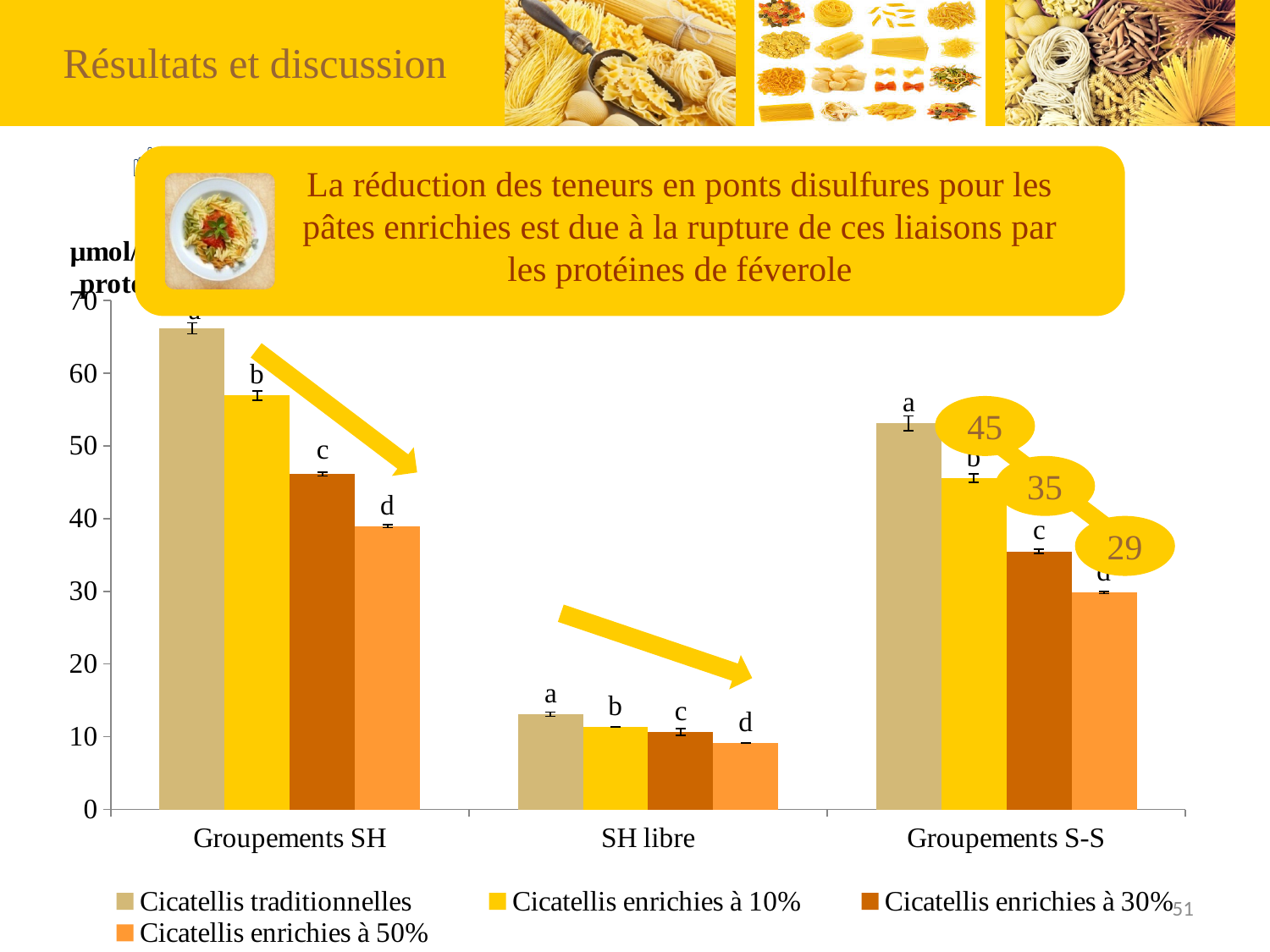
Is the value for Cicatellis traditionnelles in Groupements SH greater or less than 60? greater Within each category, do the bars rise or fall as the enrichment level increases from traditionnelles to 50%? fall Which category has the lowest bars overall? SH libre For Cicatellis enrichies à 10%, which category has the larger value: SH libre or Groupements S-S? Groupements S-S Is the value for Cicatellis enrichies à 50% in Groupements S-S greater or less than 40? less In the Groupements SH category, which series has the lowest bar? Cicatellis enrichies à 50% Is the value for Cicatellis traditionnelles in SH libre greater or less than 20? less How many series does the legend list? 4 For Cicatellis traditionnelles, which category has the larger value: Groupements SH or Groupements S-S? Groupements SH In the Groupements SH category, which series has the highest bar? Cicatellis traditionnelles What kind of chart is shown on the slide? bar chart How many categories are shown on the x axis? 3